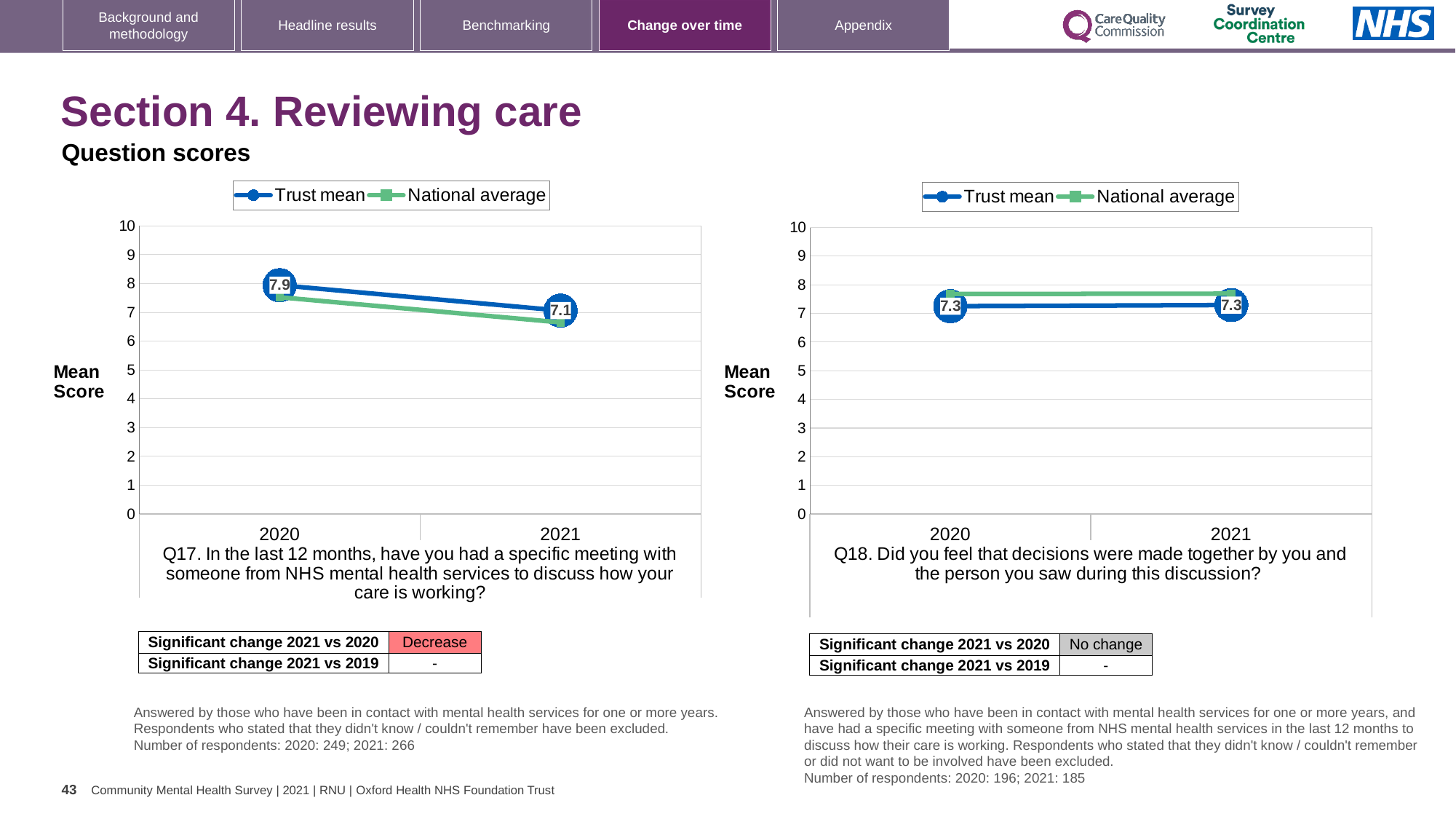
What are the two series named in the legend of the Q17 chart on the left? Trust mean and National average In the Q17 chart on the left, does the Trust mean rise or fall from 2020 to 2021? fall How many years are shown on the x axis of the Q17 chart on the left? 2 In the Q17 chart on the left, what is the Trust mean score for 2021? 7.1 What type of chart is used for the Q17 chart on the left? line chart In the Q18 chart on the right, does the Trust mean rise, fall or stay the same from 2020 to 2021? stay the same In the Q17 chart on the left, by how much did the Trust mean fall from 2020 to 2021? 0.8 In the Q17 chart on the left, is the National average for 2021 greater or less than 7? less In the Q18 chart on the right, which is higher in 2020, the Trust mean or the National average? National average In the Q18 chart on the right, what is the Trust mean score for 2021? 7.3 How many series does the legend of the Q18 chart on the right list? 2 In the Q17 chart on the left, what is the Trust mean score for 2020? 7.9